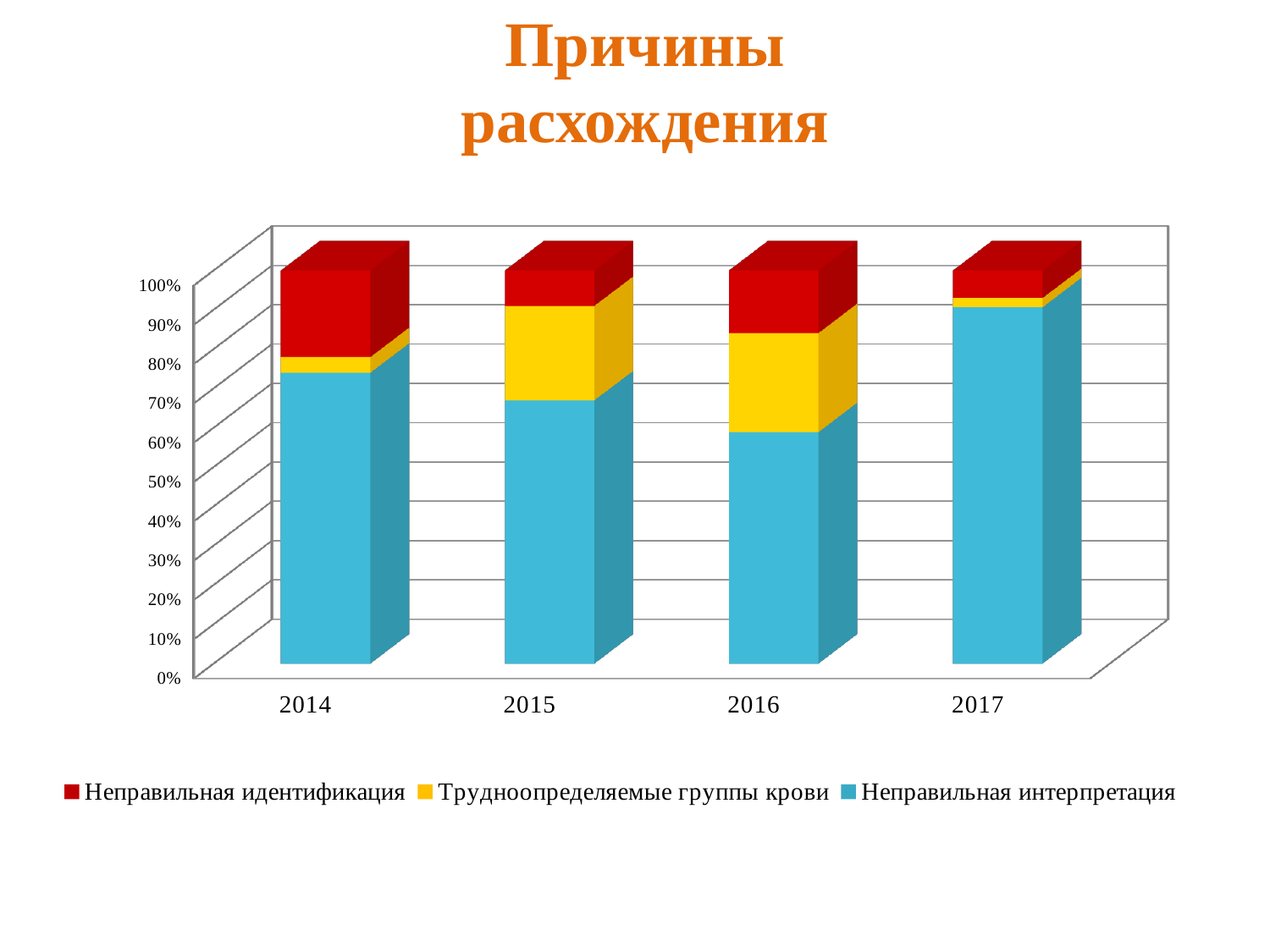
Does the share of Неправильная интерпретация rise or fall from 2014 to 2016? fall In which year is the share of Неправильная интерпретация the highest? 2017 In which year is the share of Неправильная идентификация the highest? 2014 Which year has the larger share of Трудноопределяемые группы крови, 2014 or 2015? 2015 Which series is shown in red in the chart? Неправильная идентификация How many series does the chart legend list? 3 Is the share of Неправильная интерпретация in 2016 greater or less than 70%? less In which year is the share of Неправильная интерпретация the lowest? 2016 How many years are shown on the x axis of the chart? 4 Is the share of Неправильная интерпретация in 2017 greater or less than 80%? greater What is the title of the chart on the slide? Причины расхождения What kind of chart is shown on the slide? stacked bar chart